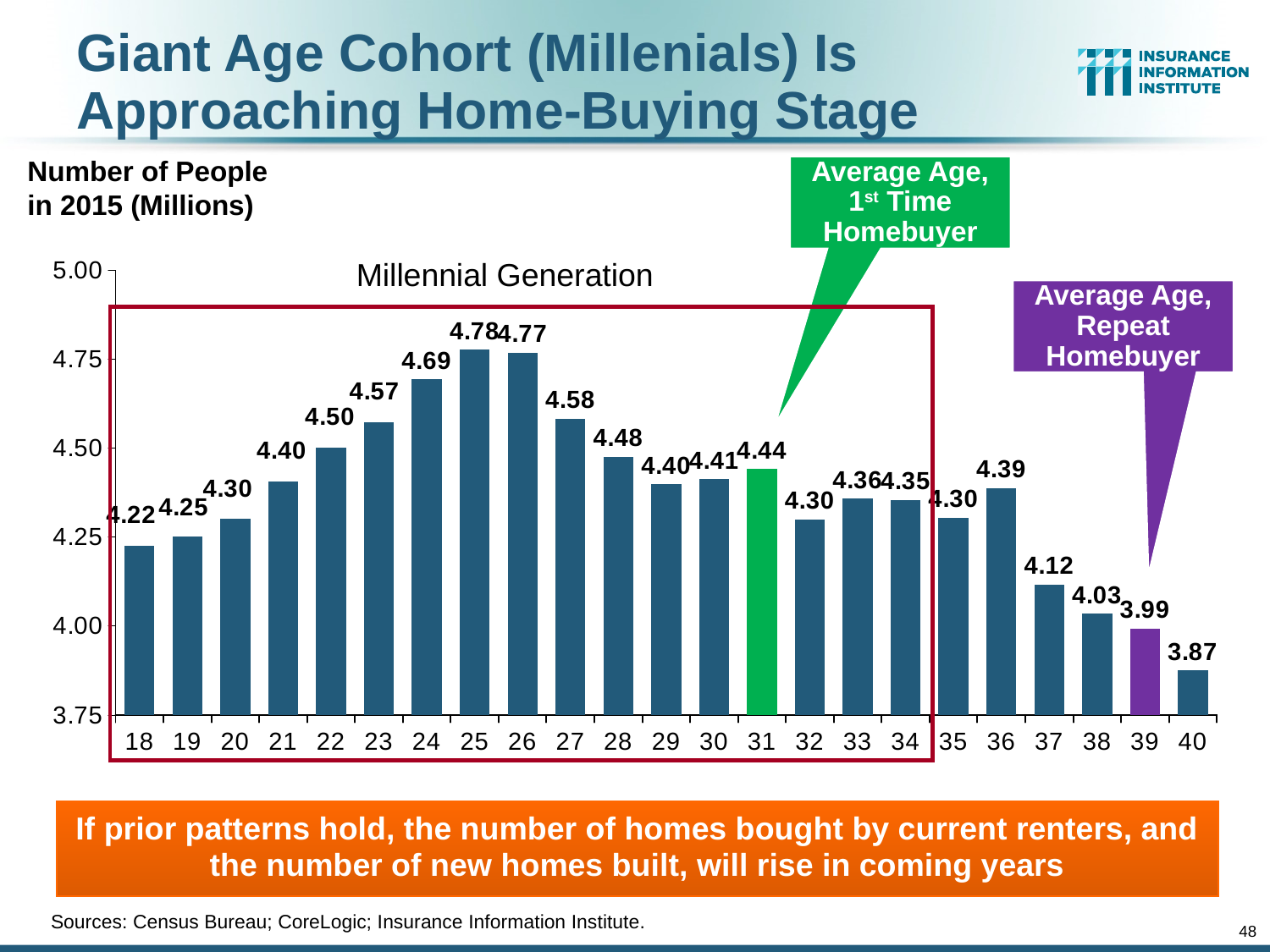
What is the difference between the values for age 25 and age 40? 0.91 What is the number of people (millions) at age 18? 4.22 Which age has the highest number of people according to the data labels? 25 What type of chart is shown on the slide? bar chart Which is larger, the value for age 36 or the value for age 37? age 36 Which age has the lowest number of people? 40 What is the value shown for age 39, the bar highlighted in purple? 3.99 What is the difference between the values for age 31 and age 39? 0.45 What is the value shown for age 31, the bar highlighted in green? 4.44 How many age categories are plotted on the chart? 23 What is the number of people (millions) at age 25? 4.78 According to the green callout, what does the highlighted bar at age 31 represent? Average Age, 1st Time Homebuyer